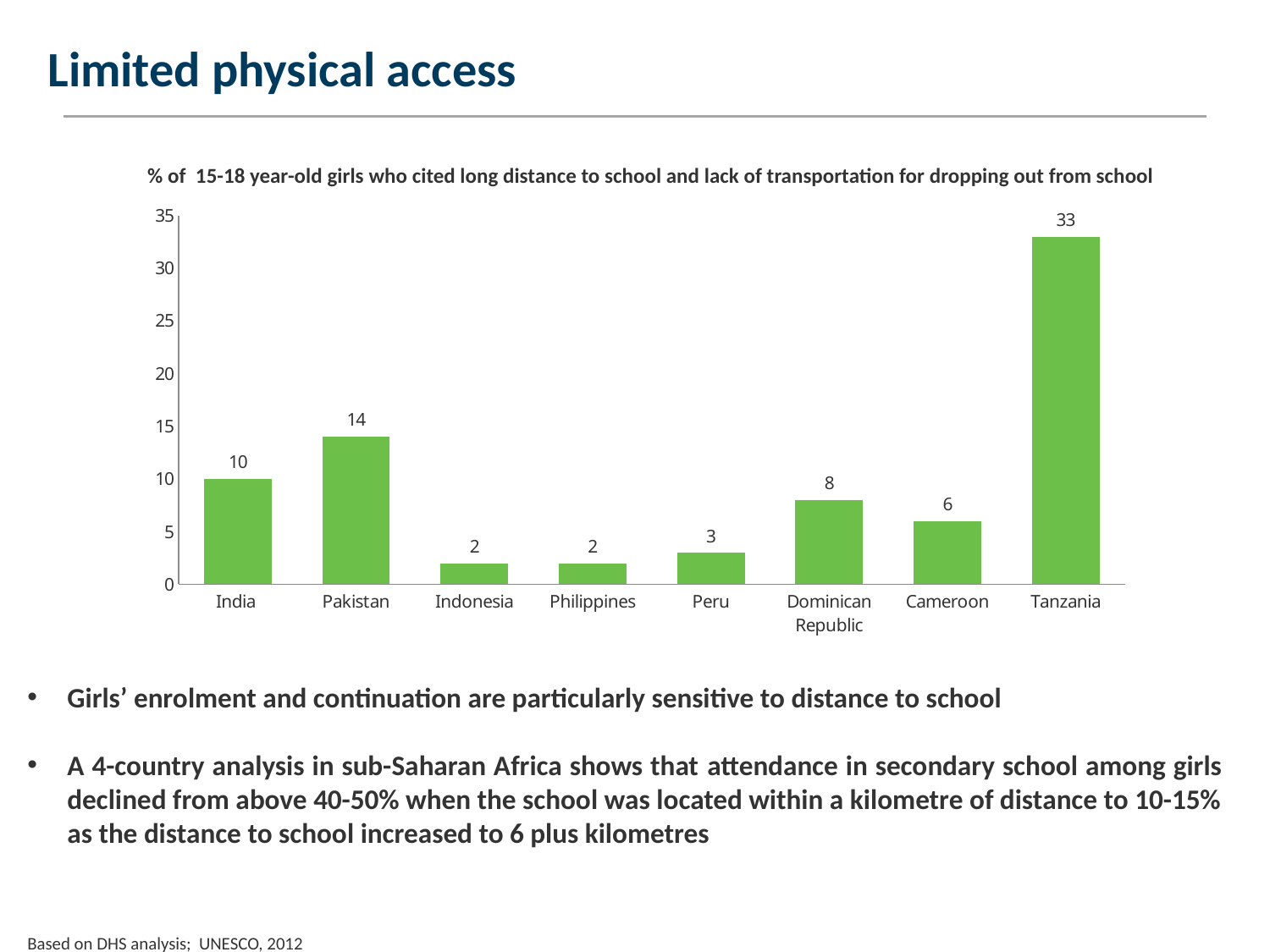
What is the value for Tanzania? 33 What is the difference between the values for Pakistan and Cameroon? 8 What is the value for Pakistan? 14 What is the difference between the values for Tanzania and India? 23 Which is larger, the value for Peru or the value for Cameroon? Cameroon Is the value for Tanzania greater or less than 30? greater Which countries share the lowest value on the chart? Indonesia and Philippines What colour are the bars in the chart? green What kind of chart is shown on the slide? bar chart Which country has the highest value? Tanzania How many countries are shown on the chart? 8 What is the value for the Dominican Republic? 8